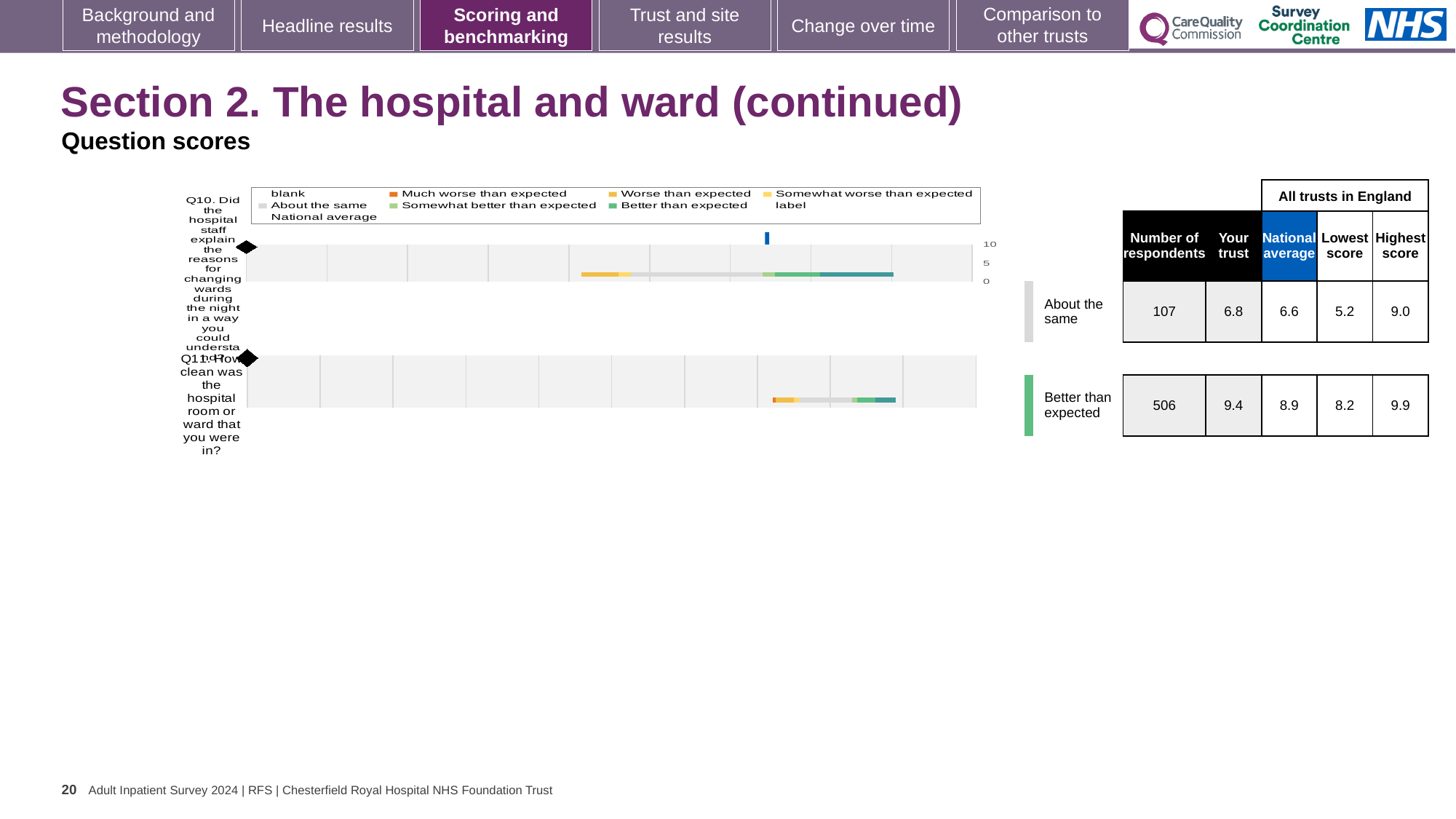
What is the national average score for Q10? 6.6 What is the difference between the trust's score and the national average for Q10? 0.2 What is the 'Your trust' score for Q10 (explaining reasons for changing wards during the night)? 6.8 Which benchmark category is Q11 placed in? Better than expected What is the 'Your trust' score for Q11 (how clean was the hospital room or ward)? 9.4 How many questions (bars) are plotted in the chart? 2 What is the difference between the highest score and the lowest score for Q11? 1.7 How many respondents answered Q11? 506 What kind of chart is shown on the slide? Bar chart Which benchmark category is Q10 placed in? About the same Which question has the higher 'Your trust' score, Q10 or Q11? Q11 What is the maximum value shown on the chart's score axis? 10